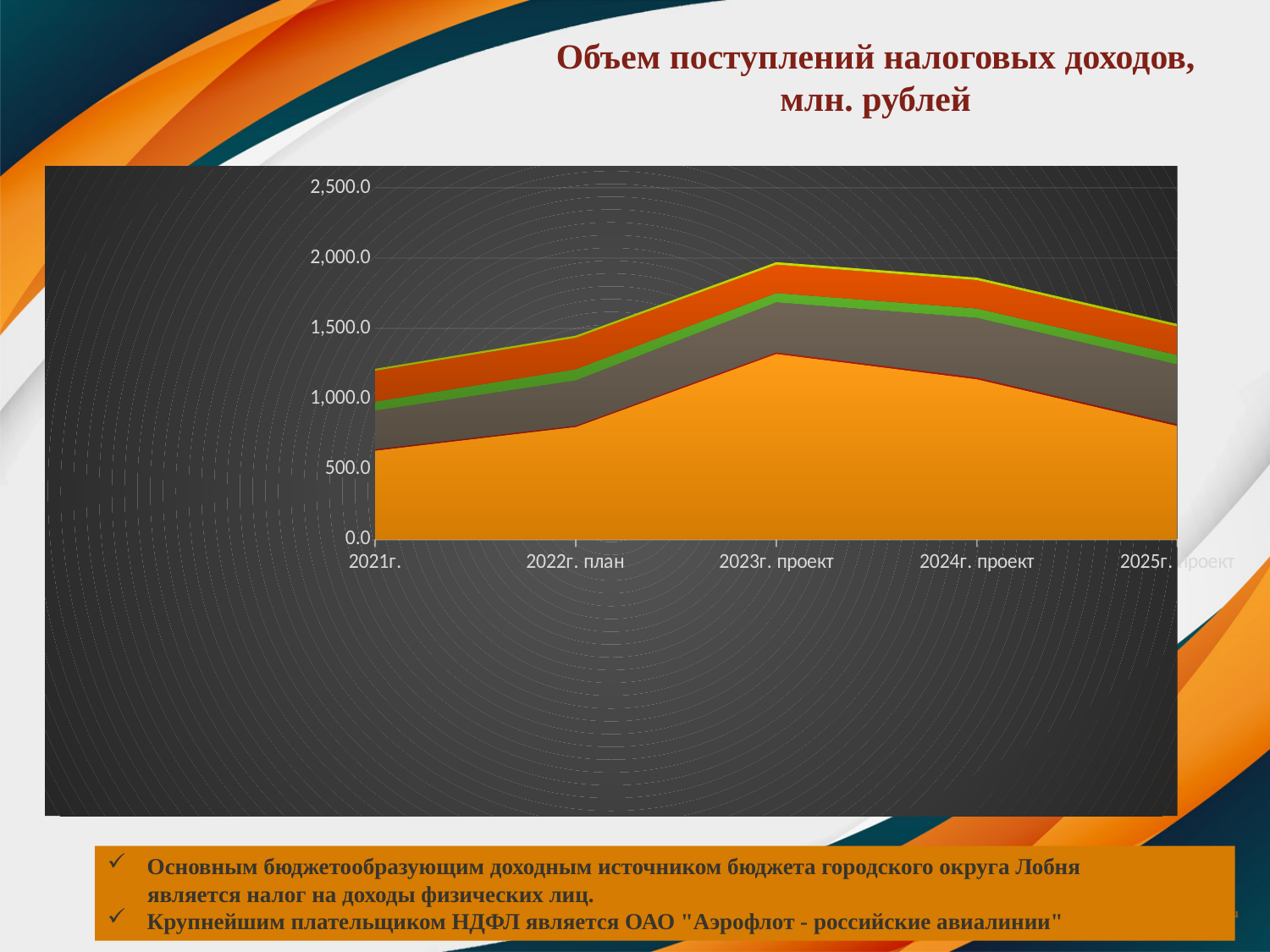
What kind of chart is shown on the slide? area chart Which has the larger total tax revenue, 2022г. план or 2024г. проект? 2024г. проект Which category has the highest total tax revenue in the chart? 2023г. проект Which category has the lowest total tax revenue in the chart? 2021г. Is the value of the bottom (orange) series for 2021г. greater or less than 1,000? less Is the total value for 2021г. greater or less than 1,500? less Is the total value for 2024г. проект greater or less than 2,000? less How many categories are shown along the x axis of the chart? 5 Does the total tax revenue rise or fall from 2023г. проект to 2025г. проект? fall